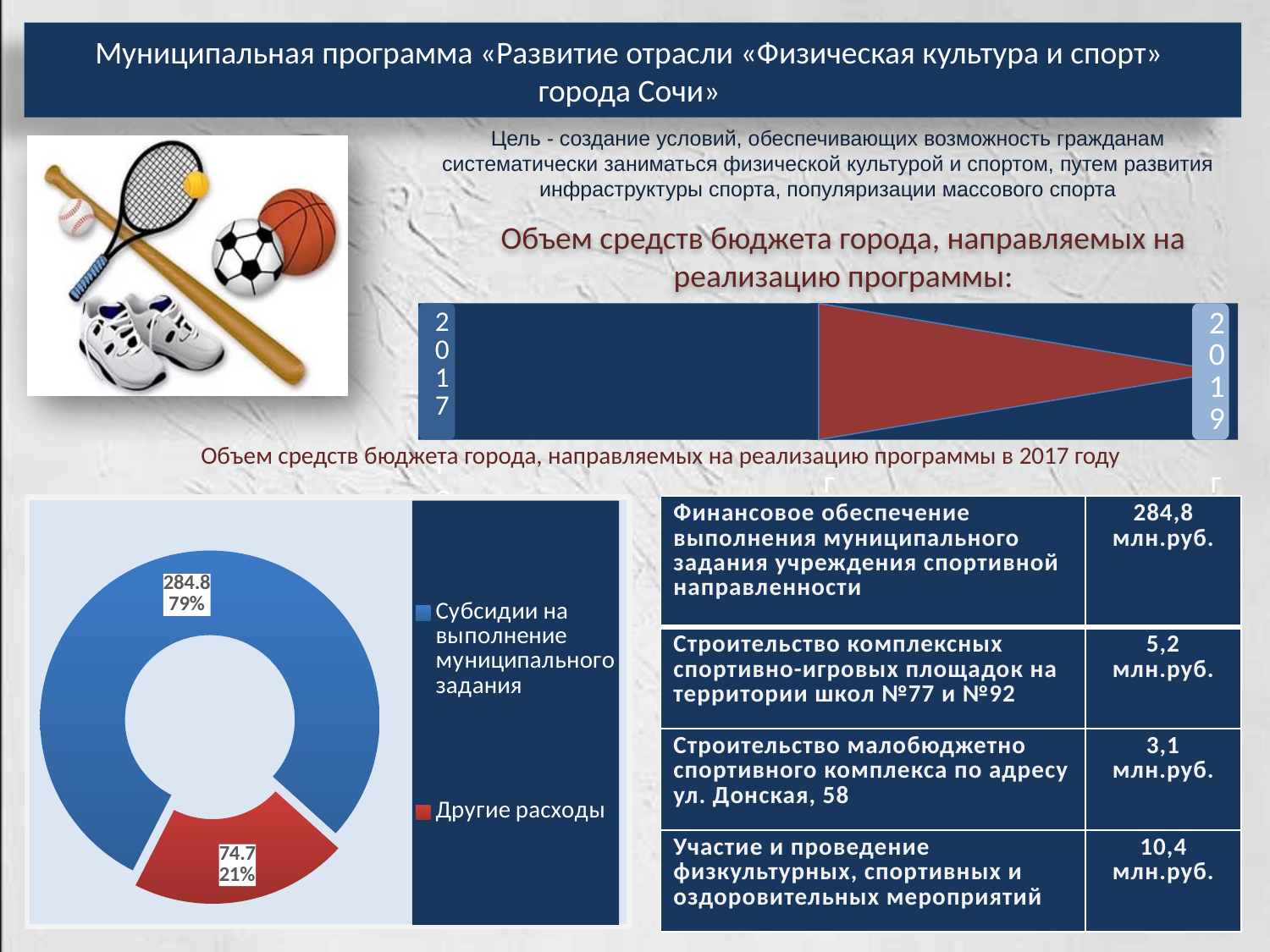
What value is shown for the "Другие расходы" slice of the doughnut chart? 74.7 What share of the doughnut chart does "Субсидии на выполнение муниципального задания" represent? 79% What share of the doughnut chart does "Другие расходы" represent? 21% Which slice of the doughnut chart is the largest? Субсидии на выполнение муниципального задания In the doughnut chart, which is larger: "Субсидии на выполнение муниципального задания" or "Другие расходы"? Субсидии на выполнение муниципального задания What colour is the "Другие расходы" slice in the doughnut chart? Red What value is shown for the "Субсидии на выполнение муниципального задания" slice of the doughnut chart? 284.8 How many slices does the doughnut chart have? 2 What is the total of the two values shown in the doughnut chart? 359.5 What is the difference between the values of the two slices in the doughnut chart? 210.1 Which slice of the doughnut chart is the smallest? Другие расходы What kind of chart is shown at the bottom left of the slide? Doughnut (pie) chart